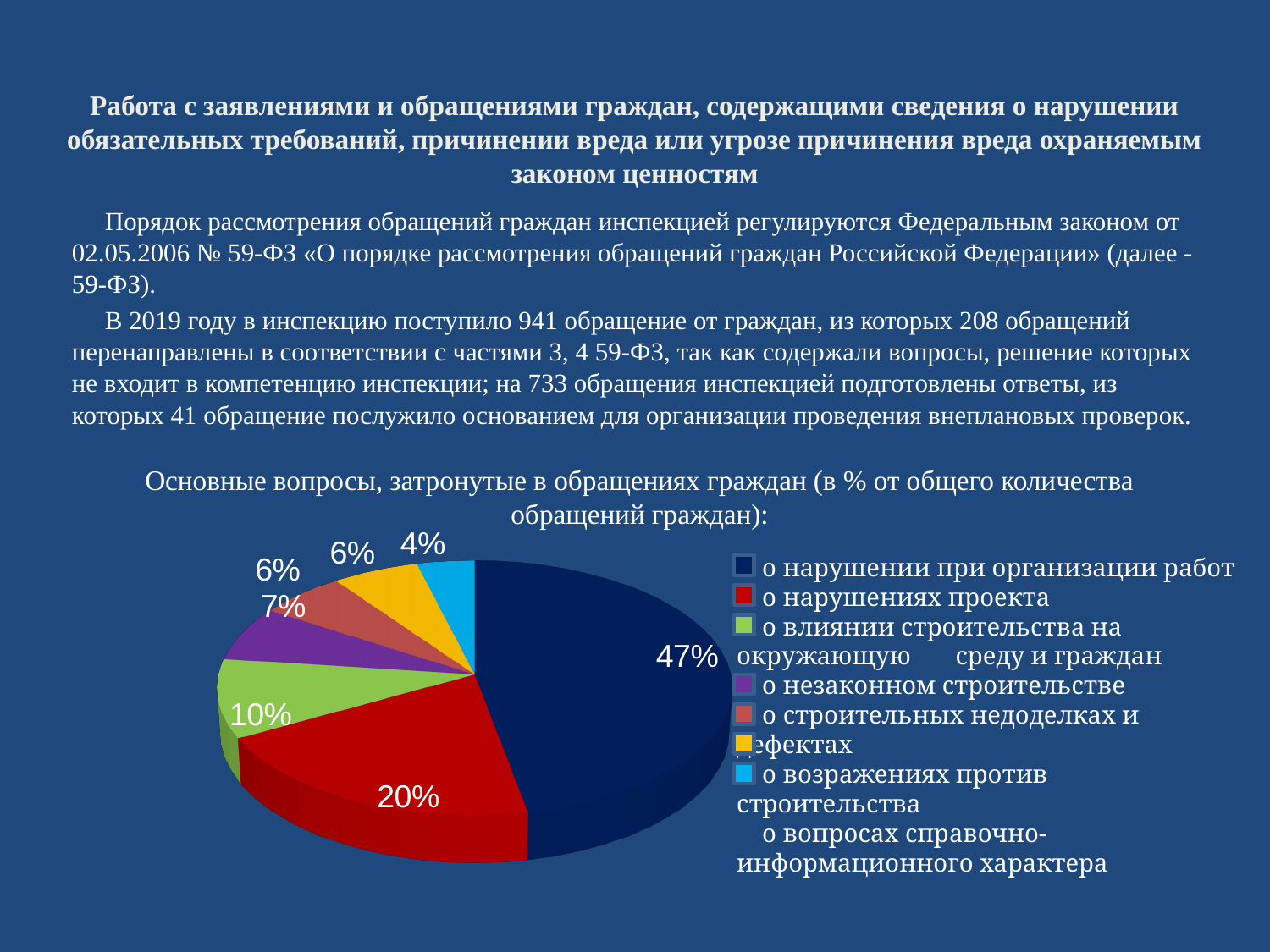
What colour is the largest slice of the pie? dark blue What kind of chart is shown on the slide? pie chart Which category has the largest slice of the pie? о нарушении при организации работ What percentage of citizens' appeals concerned «о нарушении при организации работ»? 47% What percentage is shown for «о влиянии строительства на окружающую среду и граждан»? 10% Which is larger: the slice for «о нарушениях проекта» or the slice for «о влиянии строительства на окружающую среду и граждан»? о нарушениях проекта What is the percentage of the smallest slice in the pie? 4% What percentage is shown for «о незаконном строительстве»? 7% How many slices does the pie chart have? 7 What share of the pie is labelled «о нарушениях проекта»? 20% By how many percentage points does «о нарушении при организации работ» exceed «о нарушениях проекта»? 27 What is the combined share of the two largest slices (47% and 20%)? 67%